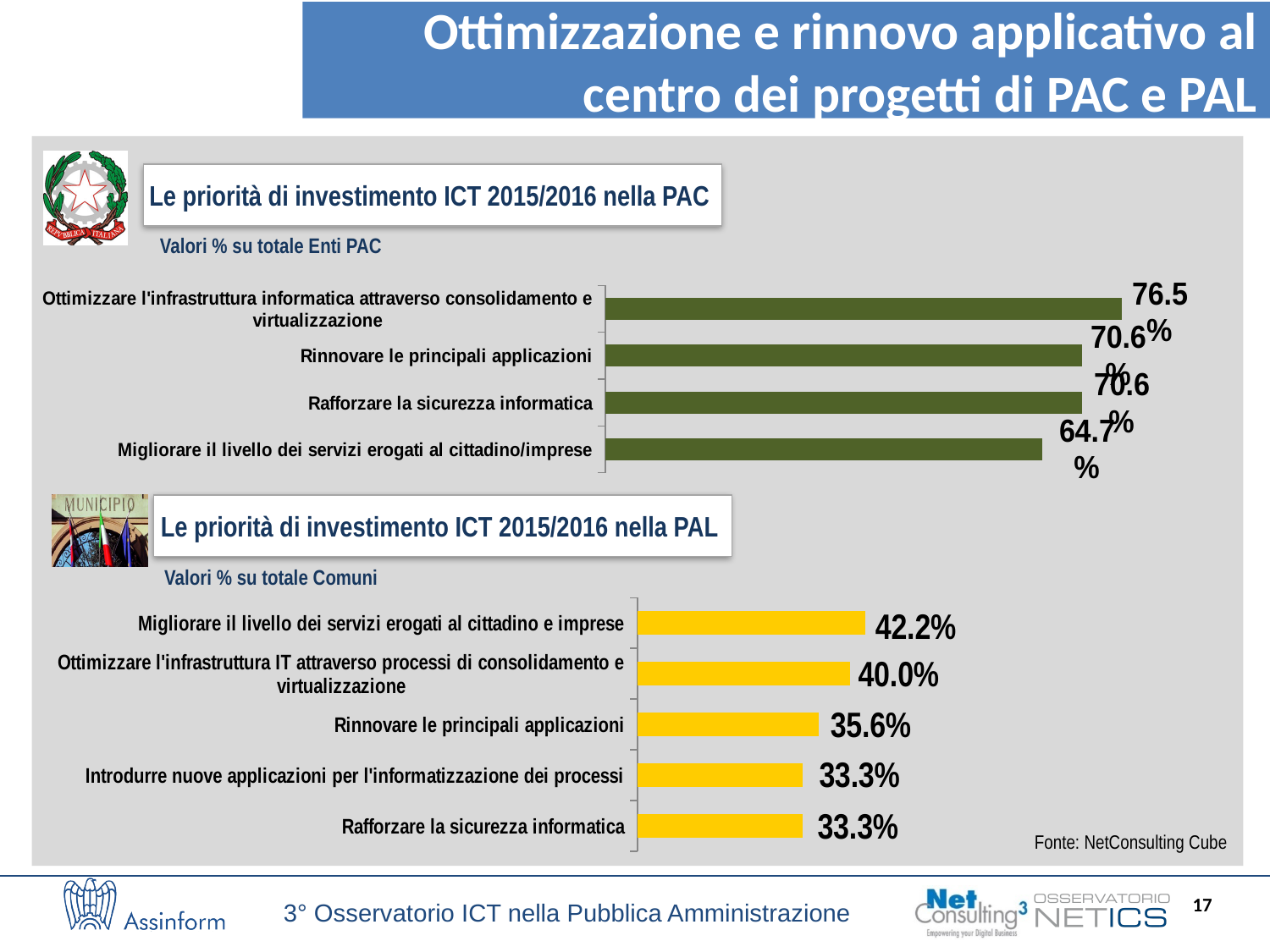
In the chart 'Le priorità di investimento ICT 2015/2016 nella PAL', what is the value for 'Rinnovare le principali applicazioni'? 35.6% What type of chart is used in 'Le priorità di investimento ICT 2015/2016 nella PAL'? Bar chart In the chart 'Le priorità di investimento ICT 2015/2016 nella PAL', how many categories are shown? 5 In the chart 'Le priorità di investimento ICT 2015/2016 nella PAL', what is the difference between 'Migliorare il livello dei servizi erogati al cittadino e imprese' and 'Ottimizzare l'infrastruttura IT attraverso processi di consolidamento e virtualizzazione'? 2.2 percentage points In the chart 'Le priorità di investimento ICT 2015/2016 nella PAC', how many categories are shown? 4 In the chart 'Le priorità di investimento ICT 2015/2016 nella PAL', which category has the highest value? Migliorare il livello dei servizi erogati al cittadino e imprese Which is larger: 'Rinnovare le principali applicazioni' in the PAC chart or 'Rinnovare le principali applicazioni' in the PAL chart? PAC chart (70.6%) In the chart 'Le priorità di investimento ICT 2015/2016 nella PAC', what is the value for 'Ottimizzare l'infrastruttura informatica attraverso consolidamento e virtualizzazione'? 76.5% In the chart 'Le priorità di investimento ICT 2015/2016 nella PAC', which category has the highest value? Ottimizzare l'infrastruttura informatica attraverso consolidamento e virtualizzazione In the chart 'Le priorità di investimento ICT 2015/2016 nella PAL', what is the value for 'Migliorare il livello dei servizi erogati al cittadino e imprese'? 42.2% In the chart 'Le priorità di investimento ICT 2015/2016 nella PAC', what is the difference between the highest and lowest values? 11.8 percentage points In the chart 'Le priorità di investimento ICT 2015/2016 nella PAC', what is the value for 'Migliorare il livello dei servizi erogati al cittadino/imprese'? 64.7%